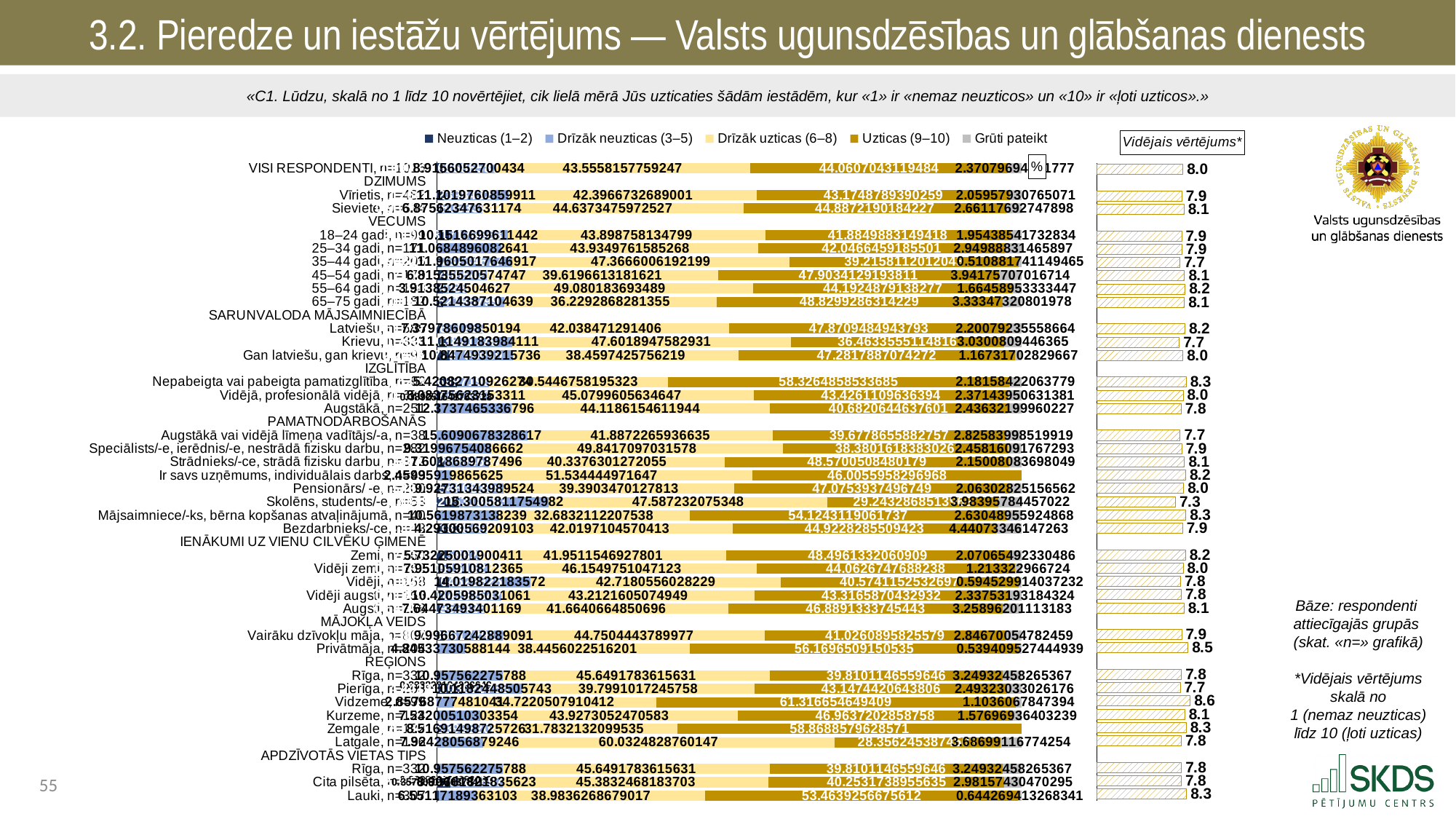
Which legend entry is shown in the darkest blue colour? Neuzticas (1–2) Which group on the slide has the lowest average rating? Skolēns, students/-e What kind of chart is shown on the slide? bar chart What is the average rating (Vidējais vērtējums) for VISI RESPONDENTI? 8.0 What is the average rating (Vidējais vērtējums) for Skolēns, students/-e? 7.3 Which region (REĢIONS) has the highest average rating? Vidzeme What is the average rating (Vidējais vērtējums) for Privātmāja? 8.5 What is the difference between the average rating for Privātmāja and for Vairāku dzīvokļu māja? 0.6 What is the difference between the average rating for Vidzeme and the average rating for Skolēns, students/-e? 1.3 How many series does the legend list? 5 Which has a higher average rating: Vīrietis or Sieviete? Sieviete What is the data label for the Uzticas (9–10) segment of the Vidzeme bar? 61.316654649409